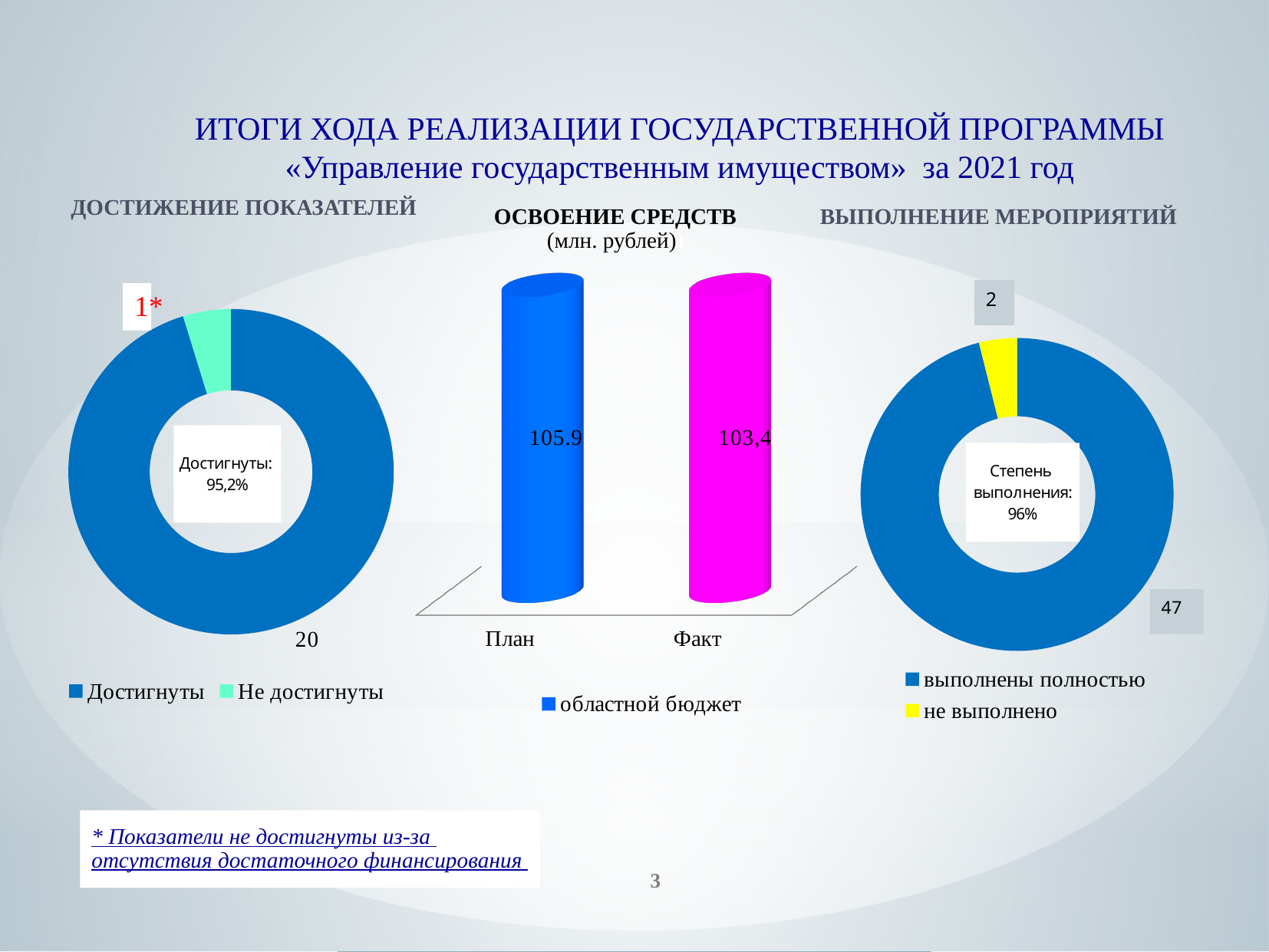
In the 'ОСВОЕНИЕ СРЕДСТВ' chart, what is the value for Факт? 103,4 In the 'ВЫПОЛНЕНИЕ МЕРОПРИЯТИЙ' chart, what is the value for 'не выполнено'? 2 In the 'ДОСТИЖЕНИЕ ПОКАЗАТЕЛЕЙ' chart, what percentage is shown in the centre for Достигнуты? 95,2% In the 'ВЫПОЛНЕНИЕ МЕРОПРИЯТИЙ' chart, what is the value for 'выполнены полностью'? 47 In the 'ОСВОЕНИЕ СРЕДСТВ' chart, what is the value for План? 105.9 In the 'ДОСТИЖЕНИЕ ПОКАЗАТЕЛЕЙ' chart, what is the value for Достигнуты? 20 In the 'ОСВОЕНИЕ СРЕДСТВ' chart, how many bars are plotted? 2 In the 'ВЫПОЛНЕНИЕ МЕРОПРИЯТИЙ' chart, what is the difference between 'выполнены полностью' and 'не выполнено'? 45 In the 'ОСВОЕНИЕ СРЕДСТВ' chart, which is larger, План or Факт? План In the 'ОСВОЕНИЕ СРЕДСТВ' chart, what kind of chart is shown? Bar chart In the 'ДОСТИЖЕНИЕ ПОКАЗАТЕЛЕЙ' chart, which category is the largest? Достигнуты In the 'ОСВОЕНИЕ СРЕДСТВ' chart, what series does the legend list? областной бюджет